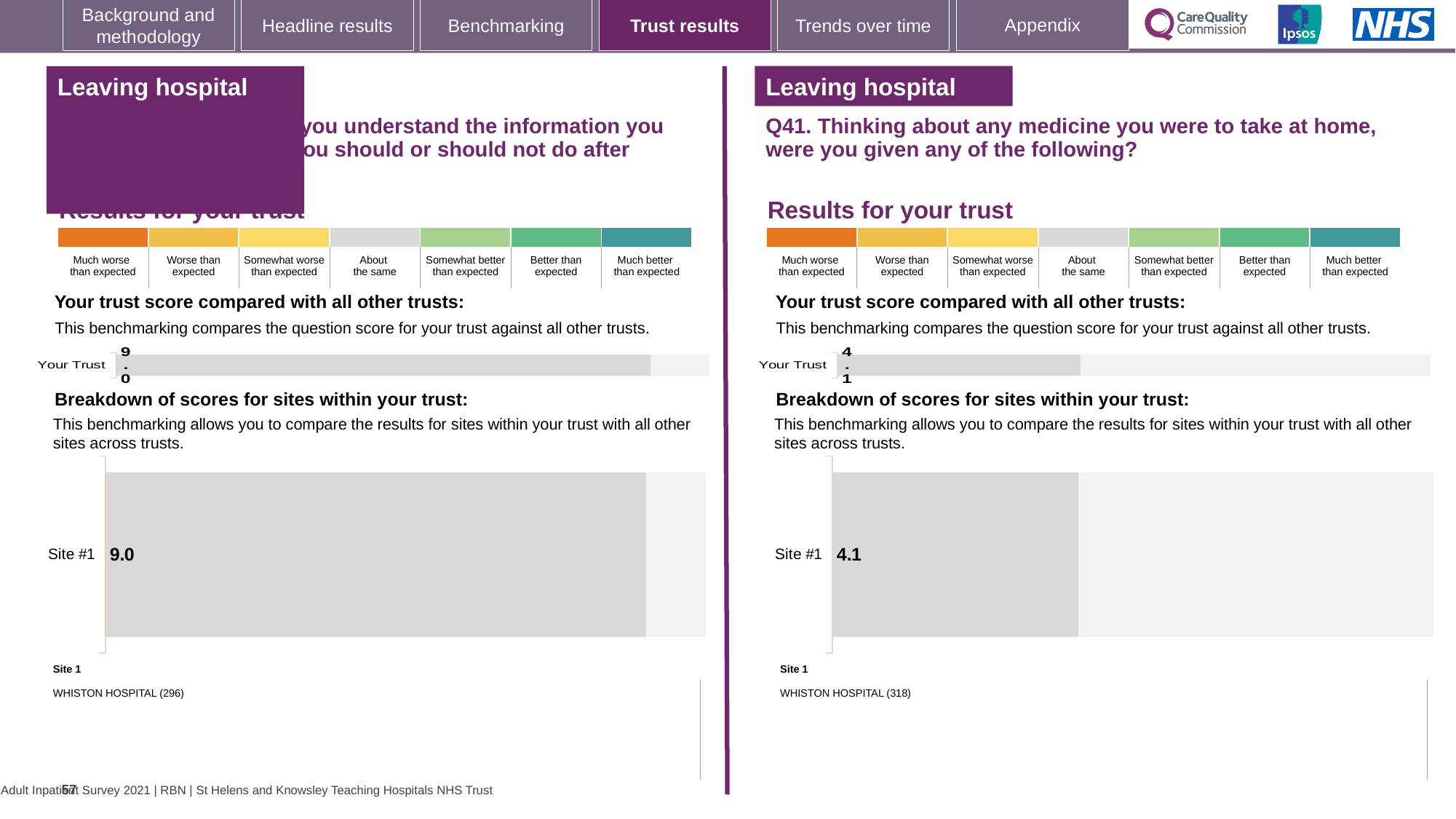
What is the difference between the Site #1 score on the left panel and the Site #1 score on the right panel (Q41)? 4.9 On the right panel (Q41), what is the 'Your Trust' score in the chart comparing the trust with all other trusts? 4.1 How many sites are shown in the breakdown of scores chart on the right panel (Q41)? 1 Is the 'Your Trust' score on the left panel equal to the Site #1 score on the same panel? Yes What kind of chart is used to show the Site #1 score on each panel? Bar chart On the right panel (Q41), what is the score shown for Site #1 in the breakdown of scores for sites within your trust? 4.1 On the left panel, which site name is listed under 'Site 1' below the breakdown chart? WHISTON HOSPITAL (296) On the right panel (Q41), which site name is listed under 'Site 1' below the breakdown chart? WHISTON HOSPITAL (318) Which panel's Site #1 bar shows the larger score, the left panel or the right panel (Q41)? Left panel On the left panel, what is the score shown for Site #1 in the breakdown of scores for sites within your trust? 9.0 On the left panel, what is the 'Your Trust' score in the chart comparing the trust with all other trusts? 9.0